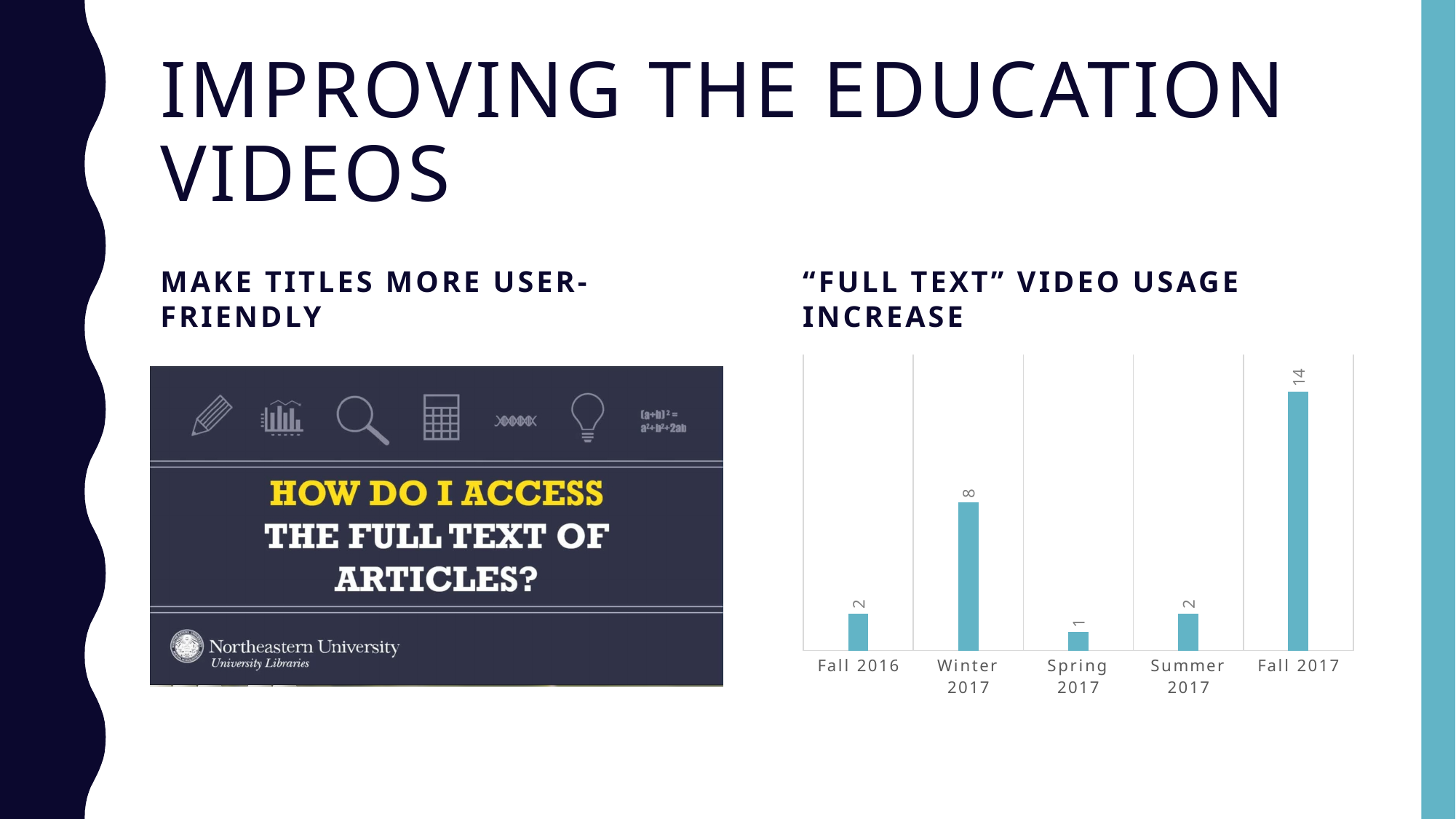
What is the heading above the chart? "Full Text" Video Usage Increase What is the difference between the values for Fall 2017 and Fall 2016? 12 What is the value for Fall 2016? 2 What is the value for Winter 2017? 8 Which period has the highest value? Fall 2017 Which is larger, the value for Winter 2017 or the value for Summer 2017? Winter 2017 What is the value for Fall 2017? 14 What is the value for Spring 2017? 1 What kind of chart is shown on the slide? Bar chart How many periods are shown on the x axis of the chart? 5 What is the difference between the values for Fall 2017 and Winter 2017? 6 Which period has the lowest value? Spring 2017